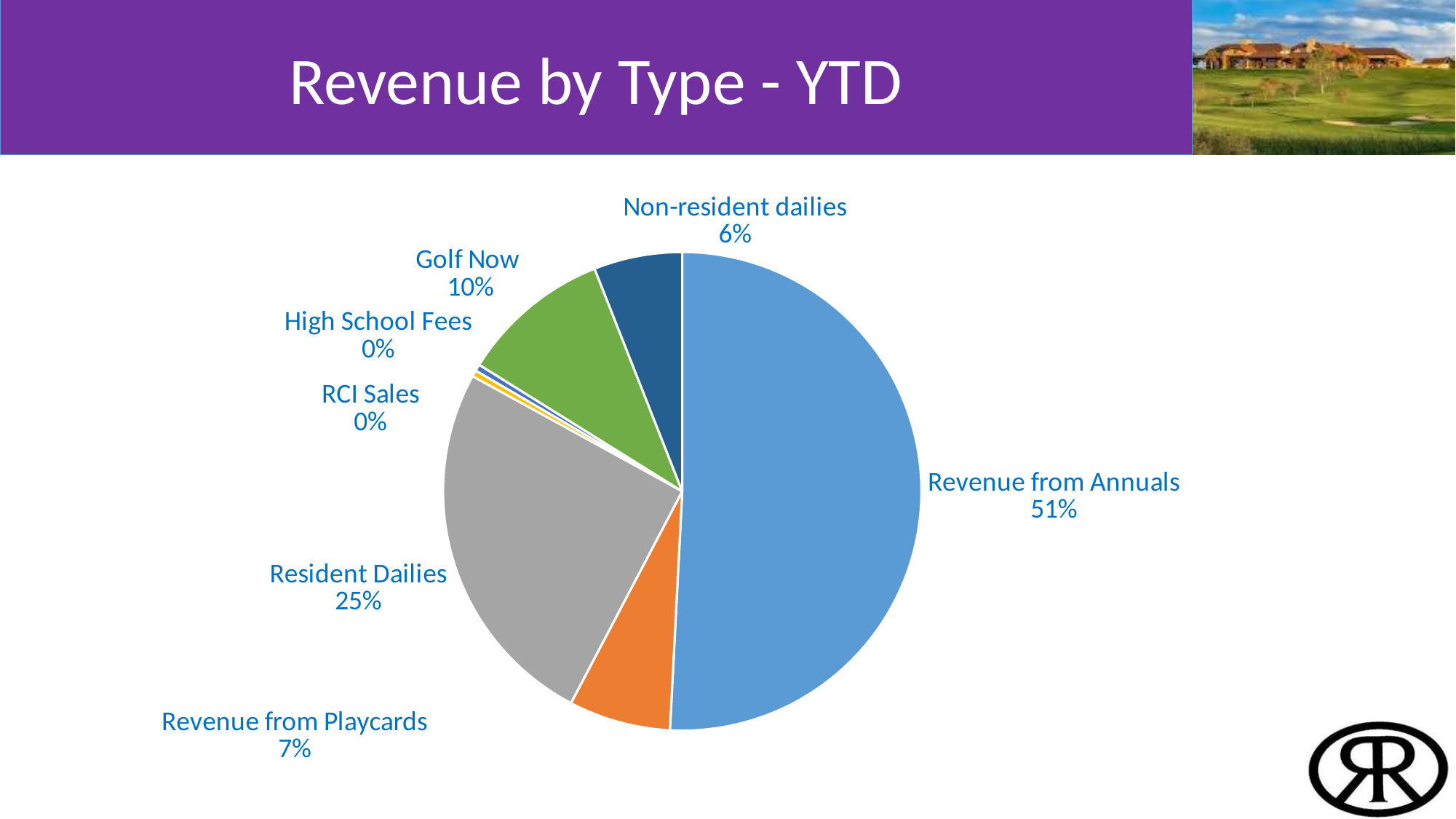
What share of revenue comes from Golf Now? 10% Which category has the largest share of revenue? Revenue from Annuals What is the combined share of Resident Dailies and Revenue from Playcards? 32% What share of revenue comes from Revenue from Playcards? 7% What kind of chart is shown on the slide? pie chart What share of revenue comes from Revenue from Annuals? 51% What is the title of the slide? Revenue by Type - YTD How many categories are shown in the pie chart? 7 Which is larger, the share for Golf Now or the share for Revenue from Playcards? Golf Now What is the difference in share between Revenue from Annuals and Resident Dailies? 26%